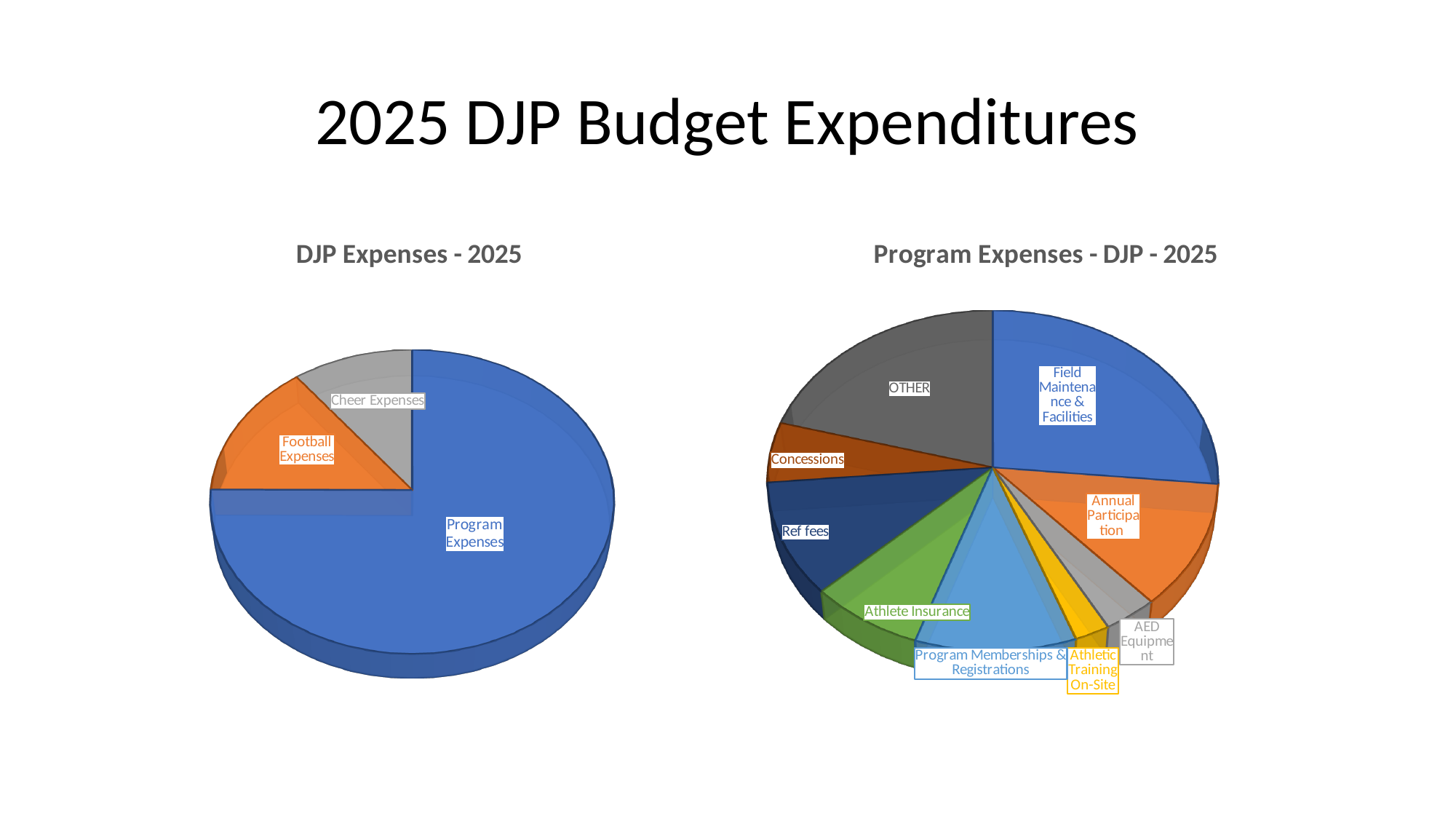
What is the title of the pie chart on the right side of the slide? Program Expenses - DJP - 2025 In the "DJP Expenses - 2025" chart, which category has the largest slice? Program Expenses What is the title of the slide? 2025 DJP Budget Expenditures What kind of chart is the "Program Expenses - DJP - 2025" chart? pie chart In the "Program Expenses - DJP - 2025" chart, which slice is larger: Athlete Insurance or Concessions? Athlete Insurance In the "Program Expenses - DJP - 2025" chart, which category has the largest slice? Field Maintenance & Facilities What kind of chart is the "DJP Expenses - 2025" chart? pie chart In the "DJP Expenses - 2025" chart, which slice is larger: Football Expenses or Cheer Expenses? Football Expenses How many slices does the "DJP Expenses - 2025" pie chart have? 3 In the "Program Expenses - DJP - 2025" chart, which slice is larger: Program Memberships & Registrations or AED Equipment? Program Memberships & Registrations How many slices does the "Program Expenses - DJP - 2025" pie chart have? 9 In the "DJP Expenses - 2025" chart, which category has the smallest slice? Cheer Expenses